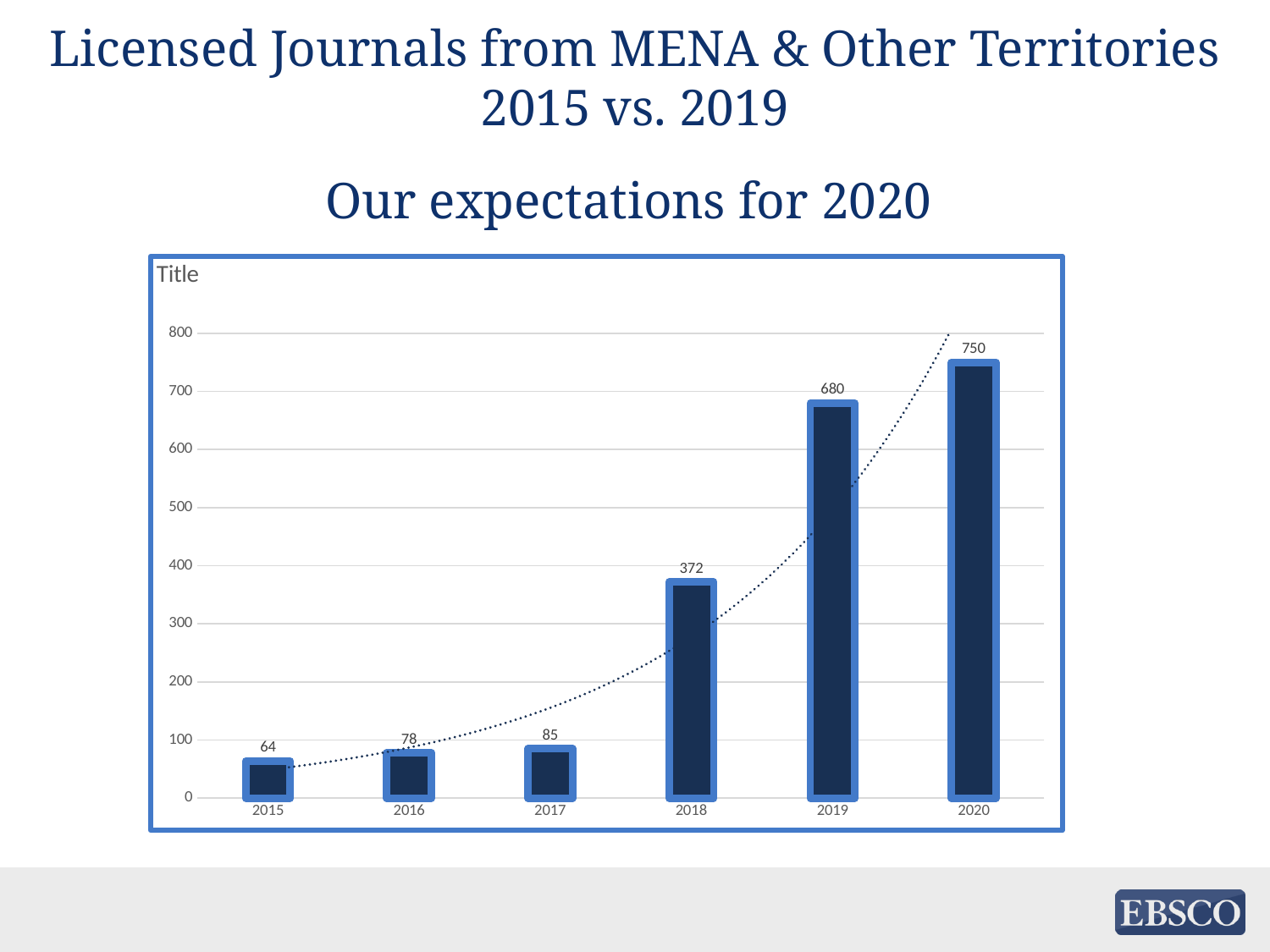
What is the difference between the values for 2019 and 2018? 308 Which is larger, the value for 2016 or the value for 2017? 2017 What is the value for 2018? 372 Is the value for 2019 greater or less than 600? greater Which year has the lowest value? 2015 What kind of chart is this? bar chart How many years are shown on the x axis? 6 What is the value for 2020? 750 What is the value for 2015? 64 What is the difference between the values for 2020 and 2019? 70 Do the values rise or fall from 2015 to 2020? rise Which year has the highest value? 2020